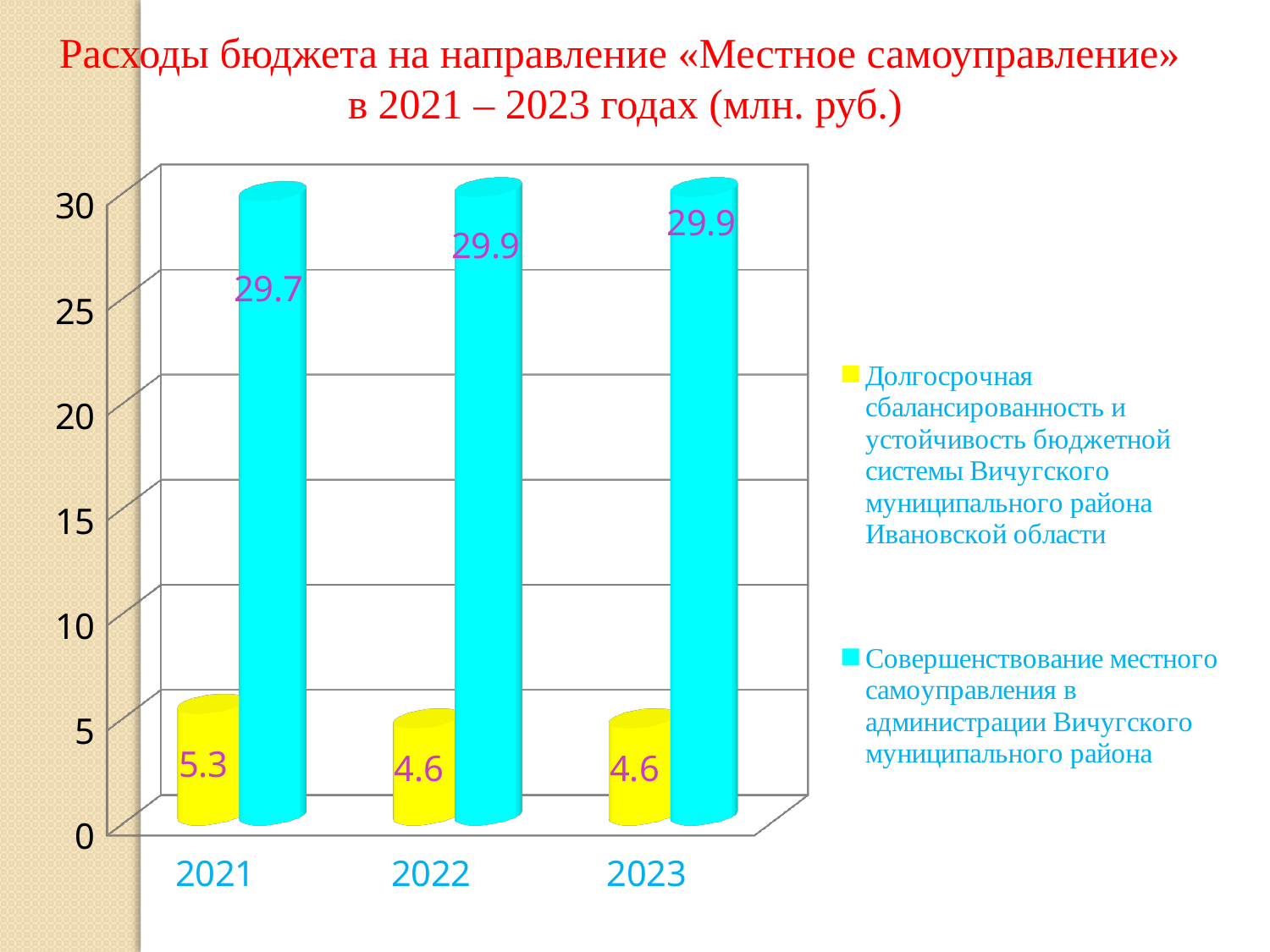
How many series does the legend list? 2 What kind of chart is shown on the slide? bar chart What is the value for the 'Долгосрочная сбалансированность' series in 2023? 4.6 What is the value for the 'Совершенствование местного самоуправления' series in 2022? 29.9 In which year is the 'Долгосрочная сбалансированность' series highest? 2021 Is the value for the 'Совершенствование местного самоуправления' series in 2023 greater or less than 25? greater How many years are shown on the x axis? 3 What is the value for the 'Совершенствование местного самоуправления' series in 2021? 29.7 What is the difference between the two series' values in 2021? 24.4 What is the value for the 'Долгосрочная сбалансированность' series in 2021? 5.3 Which series has the larger value in 2023? Совершенствование местного самоуправления What is the difference between the 'Долгосрочная сбалансированность' values in 2021 and 2022? 0.7